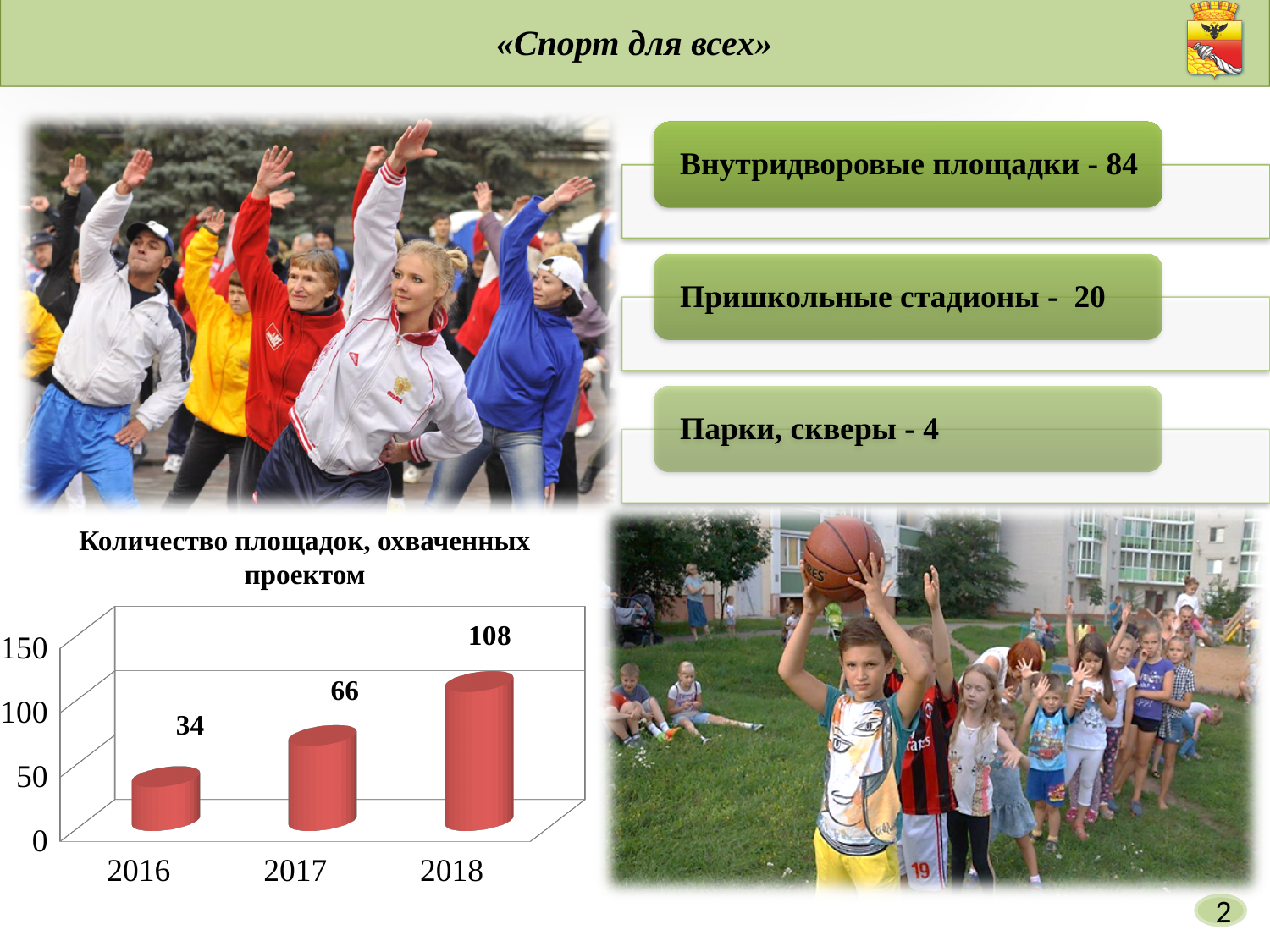
What is the value for 2016 in the chart? 34 What kind of chart is shown on the slide? bar chart How many years are shown on the x axis of the chart? 3 What is the difference between the values for 2017 and 2016? 32 Is the value for 2018 greater or less than 100? greater What is the value for 2017 in the chart? 66 Which is larger, the value for 2017 or the value for 2016? 2017 Do the values rise or fall from 2016 to 2018? rise What is the value for 2018 in the chart? 108 Which year has the highest value in the chart? 2018 What is the difference between the values for 2018 and 2017? 42 Which year has the lowest value in the chart? 2016